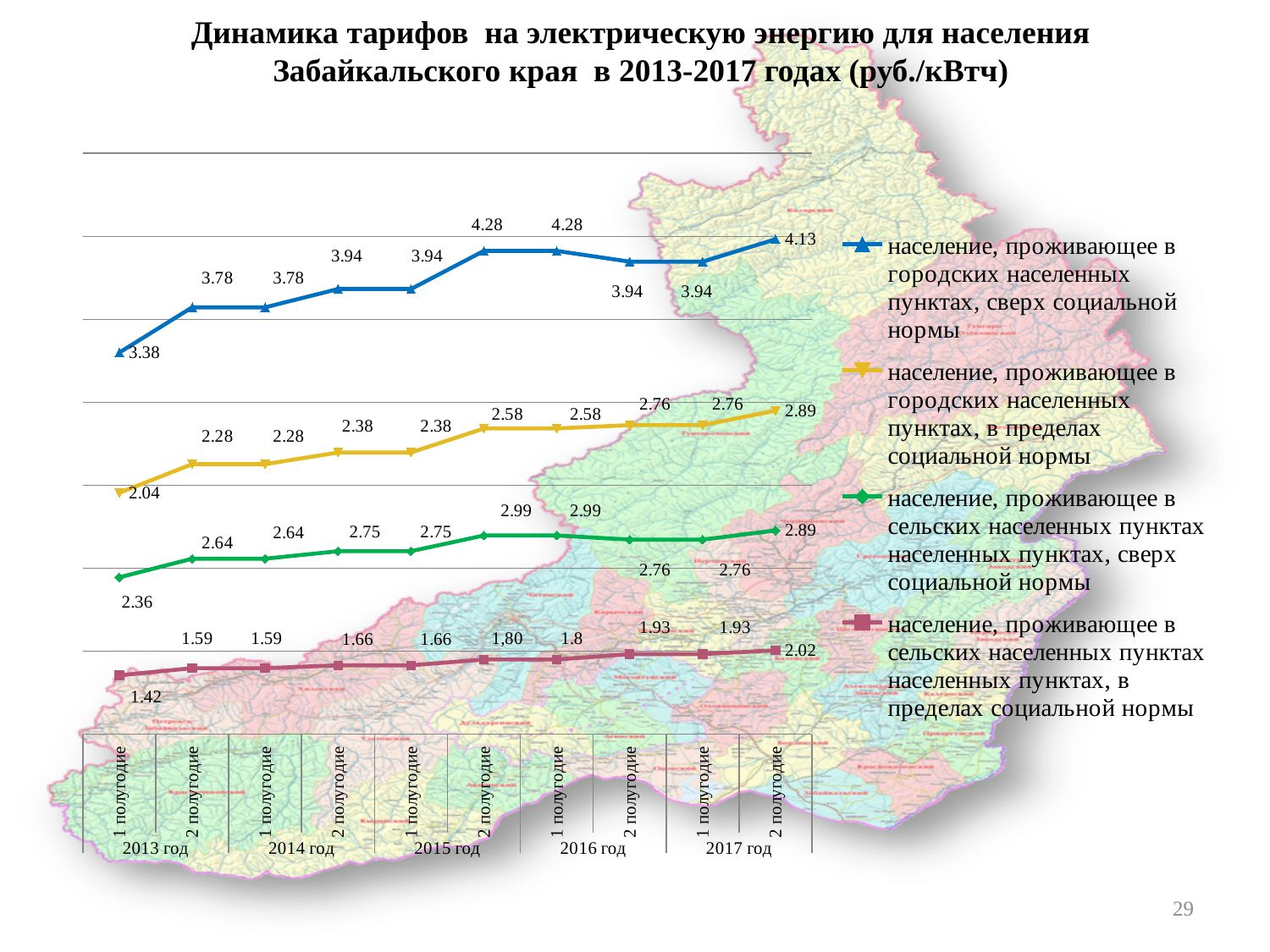
Какой тариф для населения, проживающего в городских населенных пунктах, в пределах социальной нормы, в 1 полугодии 2015 года? 2.38 Какой тариф выше во 2 полугодии 2016 года: для сельского населения сверх социальной нормы или для городского населения в пределах социальной нормы? Они равны (2.76) Какой тип диаграммы показан на слайде? Линейный график Сколько периодов (полугодий) показано на оси x графика? 10 На сколько вырос тариф для городского населения сверх социальной нормы с 1 полугодия 2013 года по 2 полугодие 2017 года? 0.75 В каком периоде тариф для городского населения сверх социальной нормы был наибольшим? 2 полугодие 2015 года и 1 полугодие 2016 года (4.28) Какой тариф для населения, проживающего в сельских населенных пунктах, сверх социальной нормы, во 2 полугодии 2015 года? 2.99 Какой тариф для населения, проживающего в городских населенных пунктах, сверх социальной нормы, в 1 полугодии 2013 года? 3.38 Какая разница между тарифами для городского населения в пределах социальной нормы и сельского населения в пределах социальной нормы во 2 полугодии 2017 года? 0.87 В каком периоде тариф для сельского населения в пределах социальной нормы был наименьшим? 1 полугодие 2013 года (1.42) Какой тариф для населения, проживающего в сельских населенных пунктах, в пределах социальной нормы, во 2 полугодии 2017 года? 2.02 Сколько рядов данных перечислено в легенде графика? 4